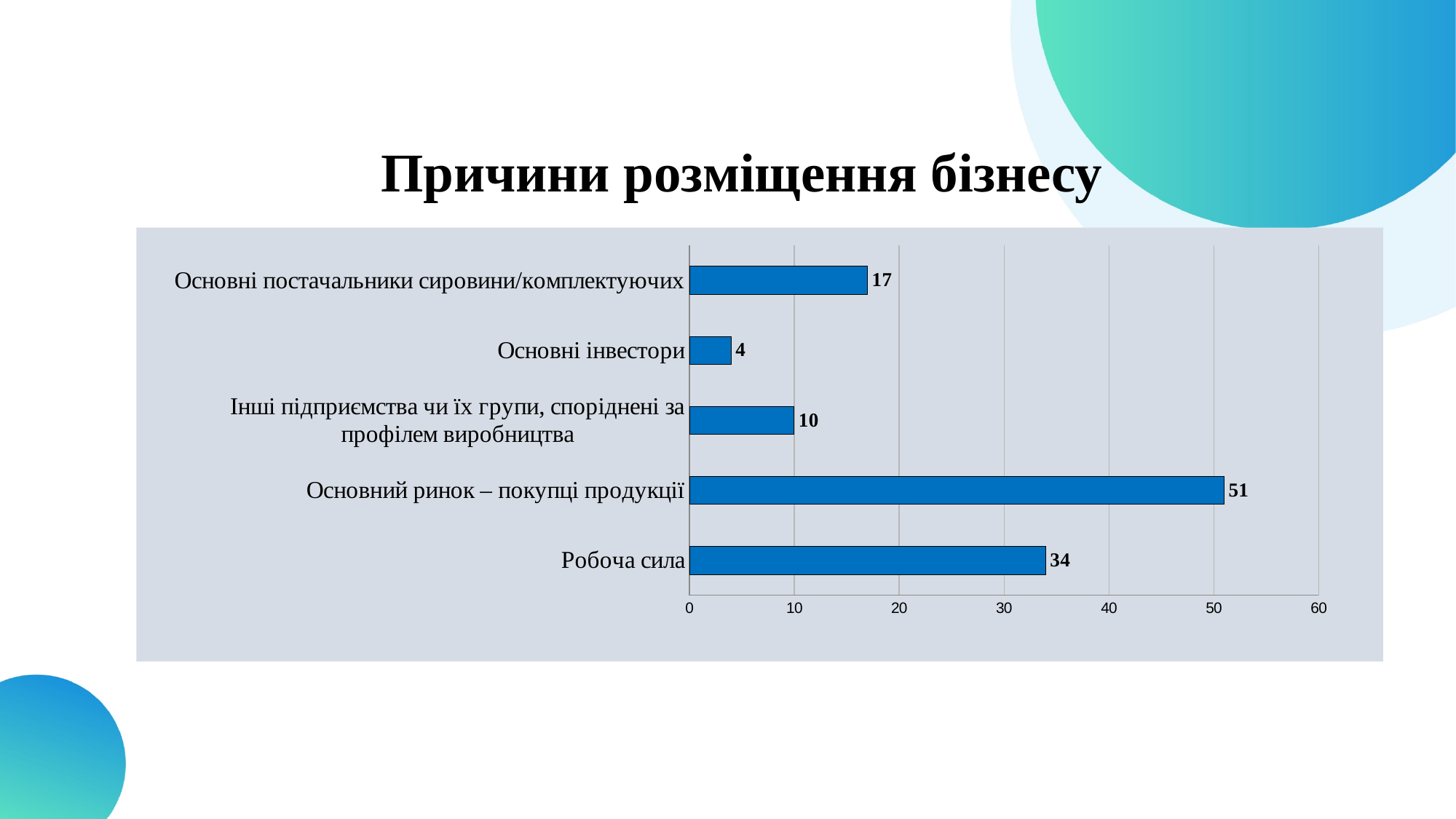
What is the value for Основні інвестори? 4 What kind of chart is shown on the slide? bar chart What is the value for Основні постачальники сировини/комплектуючих? 17 Which is larger: the value for Робоча сила or the value for Основні постачальники сировини/комплектуючих? Робоча сила What is the title of the slide? Причини розміщення бізнесу What is the value for Робоча сила? 34 What is the value for Основний ринок – покупці продукції? 51 Is the value for Інші підприємства чи їх групи, споріднені за профілем виробництва greater or less than 20? less Which category has the highest value? Основний ринок – покупці продукції What is the difference between the values for Основний ринок – покупці продукції and Робоча сила? 17 Which category has the lowest value? Основні інвестори How many categories are shown in the chart? 5